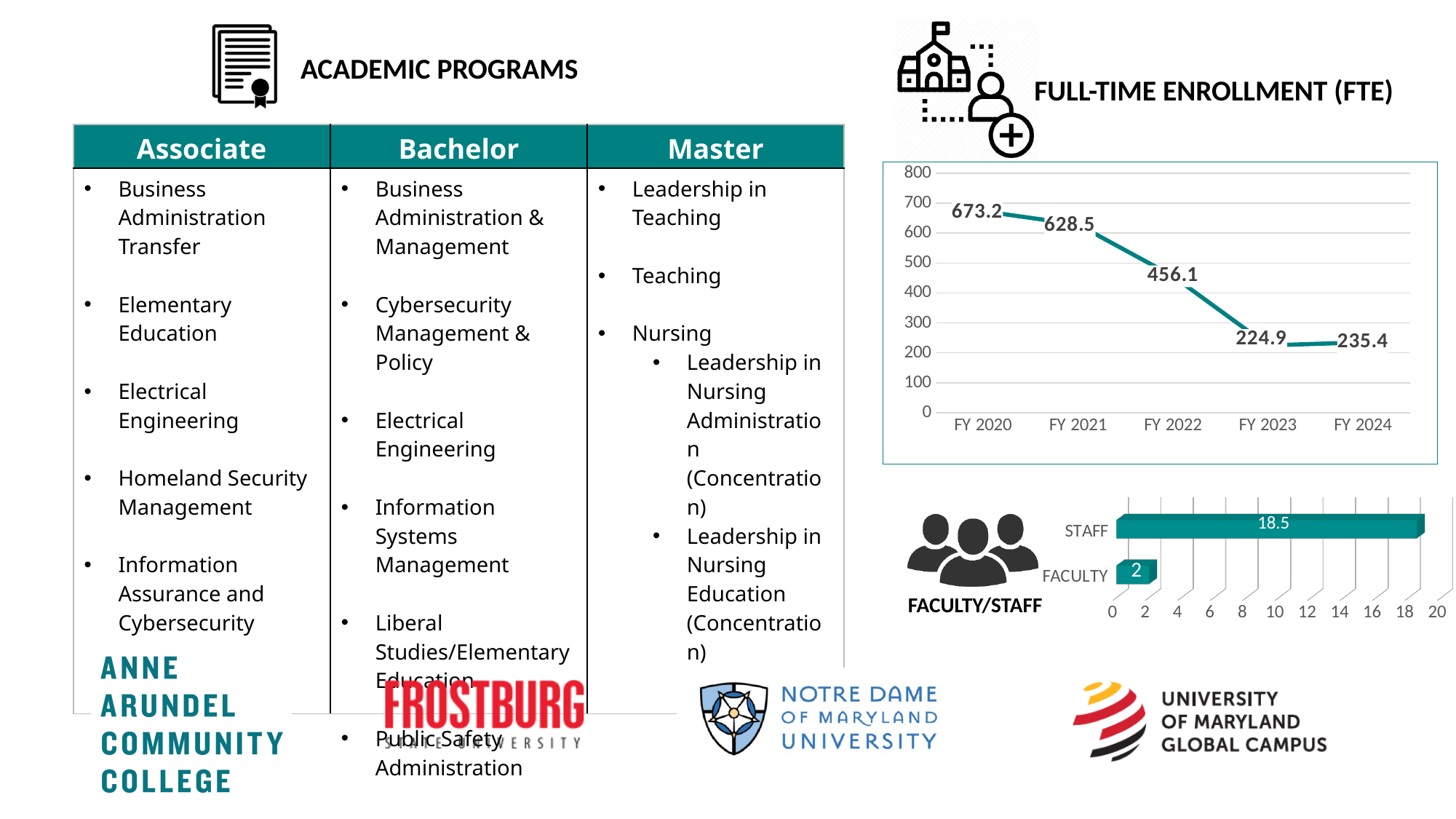
In the Full-Time Enrollment (FTE) chart, what is the value for FY 2022? 456.1 In the Full-Time Enrollment (FTE) chart, which fiscal year has the lowest value? FY 2023 In the Faculty/Staff chart, what is the difference between the STAFF and FACULTY values? 16.5 What kind of chart is the Faculty/Staff chart? bar chart In the Full-Time Enrollment (FTE) chart, which fiscal year has the highest value? FY 2020 In the Full-Time Enrollment (FTE) chart, what is the difference between the FY 2020 and FY 2021 values? 44.7 In the Full-Time Enrollment (FTE) chart, how many fiscal years are plotted? 5 What kind of chart is the Full-Time Enrollment (FTE) chart? line chart In the Full-Time Enrollment (FTE) chart, do the values generally rise or fall from FY 2020 to FY 2023? fall In the Full-Time Enrollment (FTE) chart, is the value for FY 2021 greater or less than 600? greater In the Faculty/Staff chart, what is the value for STAFF? 18.5 In the Full-Time Enrollment (FTE) chart, what is the value for FY 2024? 235.4